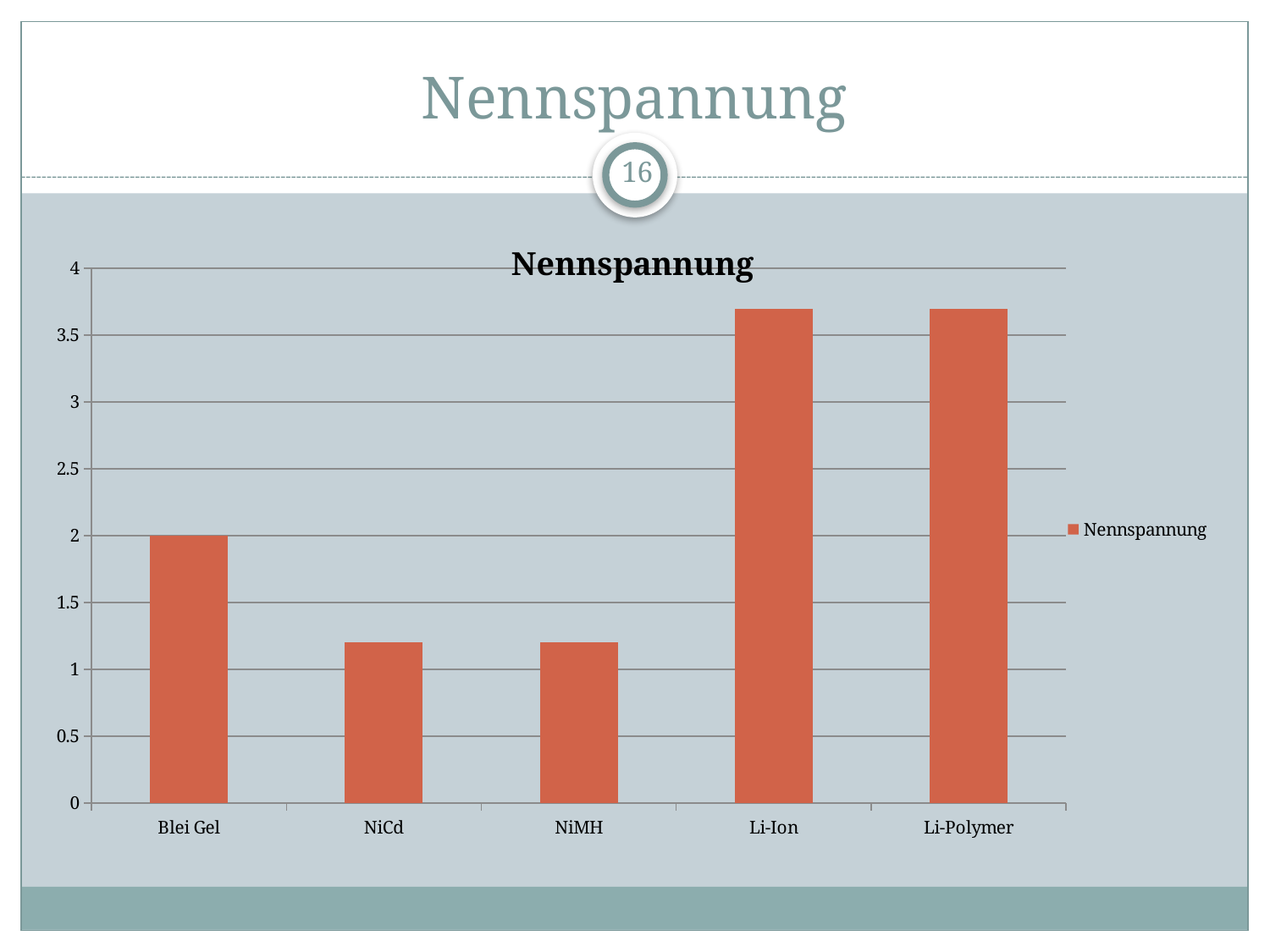
Is the value for Li-Ion greater or less than 3.5? greater Which has the larger value, NiMH or Li-Ion? Li-Ion How many categories are shown on the x axis? 5 What kind of chart is shown? bar chart Which has the larger value, Blei Gel or NiCd? Blei Gel Is the value for Li-Polymer greater or less than 3? greater What is the title of the chart? Nennspannung Which has the larger value, Li-Polymer or Blei Gel? Li-Polymer How many series does the legend list? 1 Is the value for NiCd greater or less than 1.5? less What is the value for Blei Gel? 2